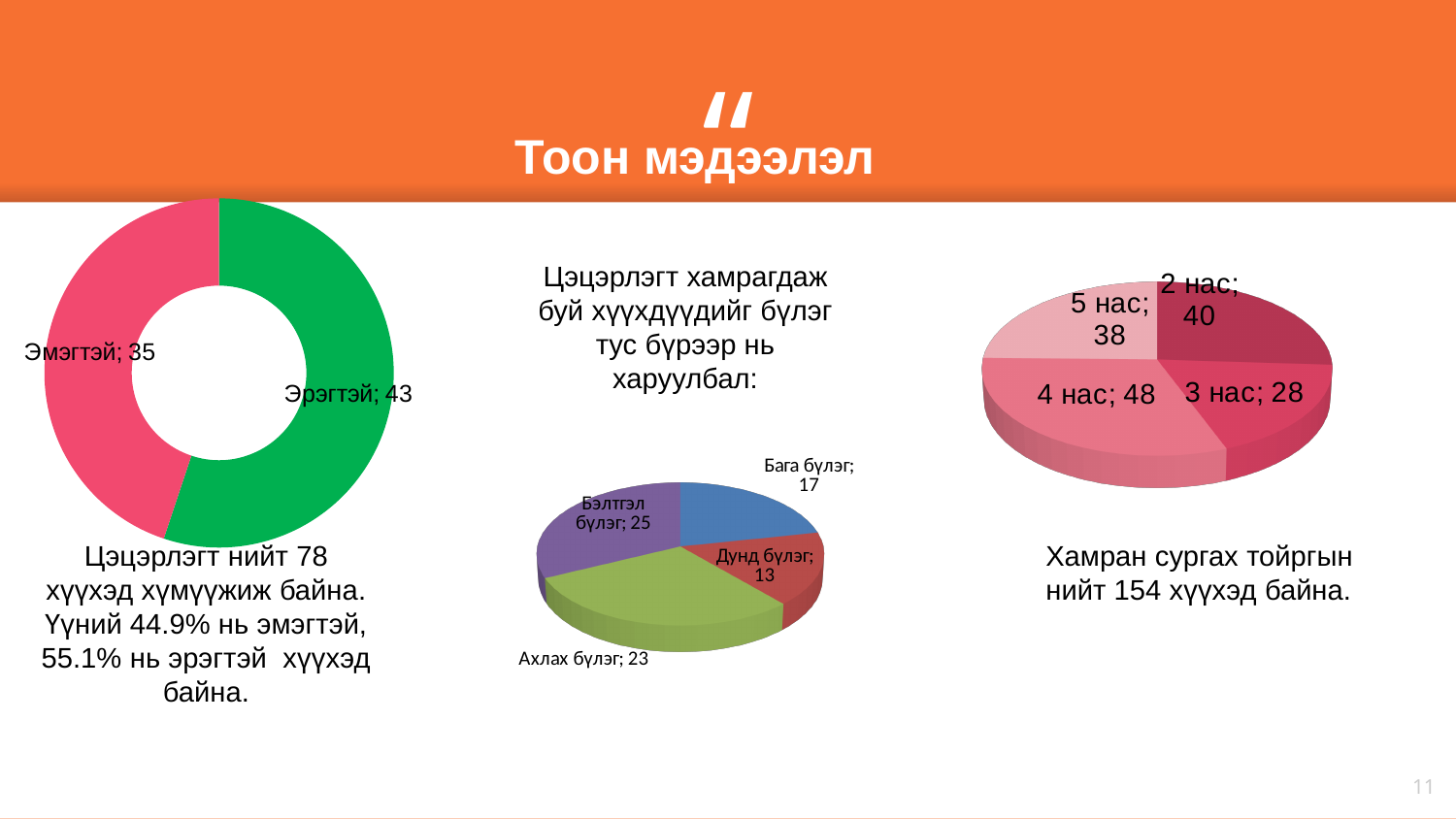
In the pie chart in the middle of the slide, what is the value for Ахлах бүлэг? 23 In the pie chart on the right, which is larger: 2 нас or 5 нас? 2 нас In the doughnut chart on the left, what is the value for Эмэгтэй? 35 What kind of chart is the chart on the left of the slide? Doughnut chart How many categories are shown in the pie chart in the middle of the slide? 4 In the doughnut chart on the left, what is the value for Эрэгтэй? 43 In the pie chart in the middle of the slide, what is the total of all slices? 78 In the pie chart on the right, what is the value for 4 нас? 48 In the pie chart on the right, which category has the lowest value? 3 нас In the pie chart in the middle of the slide, which category has the lowest value? Дунд бүлэг In the pie chart in the middle of the slide, which category has the highest value? Бэлтгэл бүлэг In the doughnut chart on the left, what is the difference between Эрэгтэй and Эмэгтэй? 8